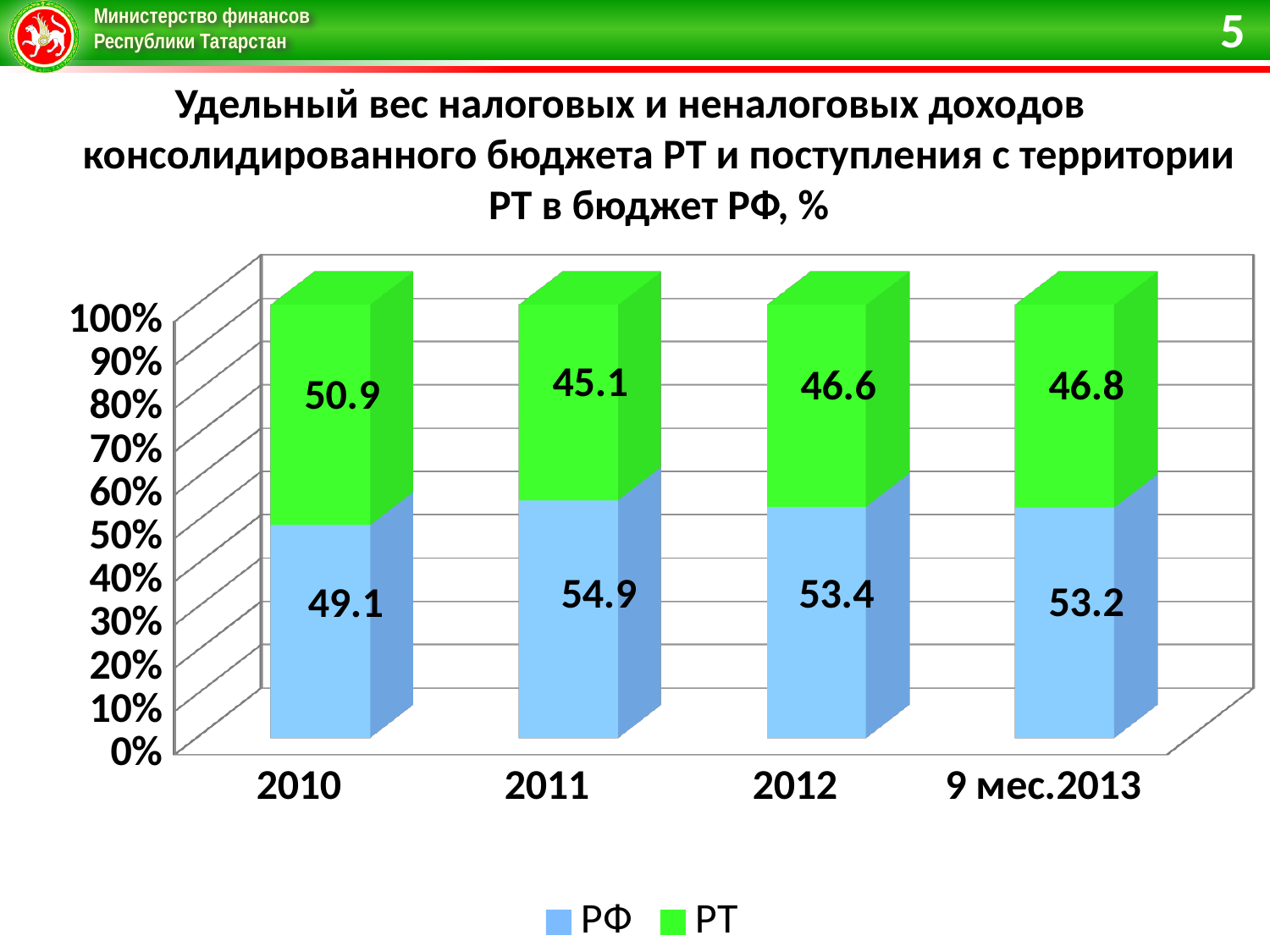
In which year is the РТ value lowest? 2011 What kind of chart is shown on the slide? Stacked bar chart In which year is the РФ value highest? 2011 Which is larger in 2010, the РФ value or the РТ value? РТ What is the value for РФ in 2012? 53.4 What is the difference between the РФ value in 2011 and the РФ value in 2010? 5.8 What is the value for РФ in 2010? 49.1 Which colour represents the РТ series in the legend? Green How many series does the legend list? 2 How many categories are shown on the x axis? 4 What is the value for РТ in 2011? 45.1 What is the value for РТ in 9 мес.2013? 46.8